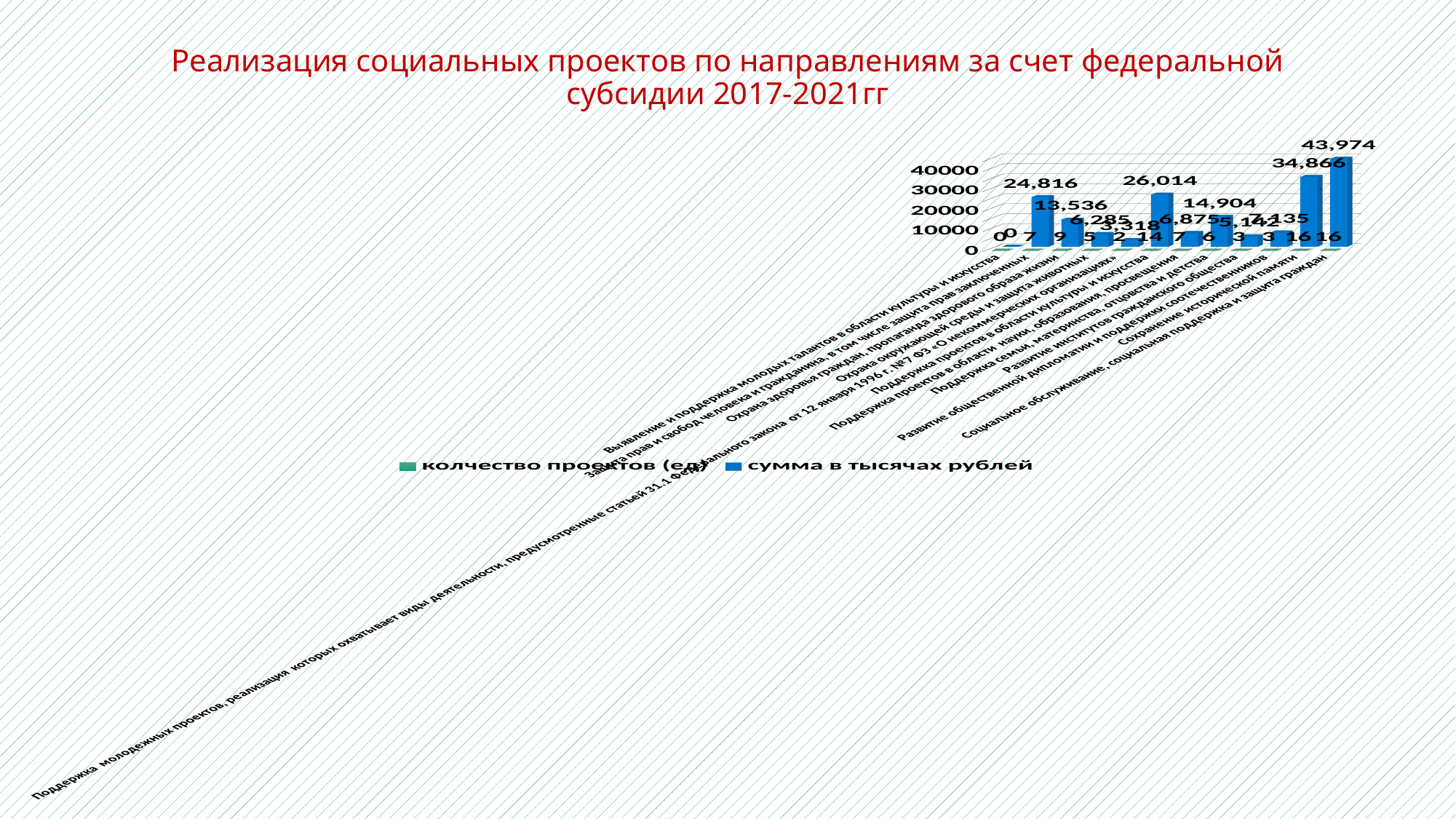
What is the highest value of the series 'колчество проектов (ед)'? 16 How many series does the chart legend list? 2 What is the title of the chart slide? Реализация социальных проектов по направлениям за счет федеральной субсидии 2017-2021гг Which category has the highest value for 'сумма в тысячах рублей'? Социальное обслуживание, социальная поддержка и защита граждан Is the value of 'сумма в тысячах рублей' for 'Социальное обслуживание, социальная поддержка и защита граждан' greater or less than 40000? greater What is the value of 'колчество проектов (ед)' for 'Социальное обслуживание, социальная поддержка и защита граждан'? 16 What is the difference in 'сумма в тысячах рублей' between 'Социальное обслуживание, социальная поддержка и защита граждан' and 'Сохранение исторической памяти'? 9,108 What is the lowest value shown for the series 'сумма в тысячах рублей'? 0 What type of chart is shown on the slide? bar chart What is the highest value of the series 'сумма в тысячах рублей'? 43,974 What are the two series named in the chart legend? колчество проектов (ед) and сумма в тысячах рублей What is the value of 'сумма в тысячах рублей' for 'Сохранение исторической памяти'? 34,866